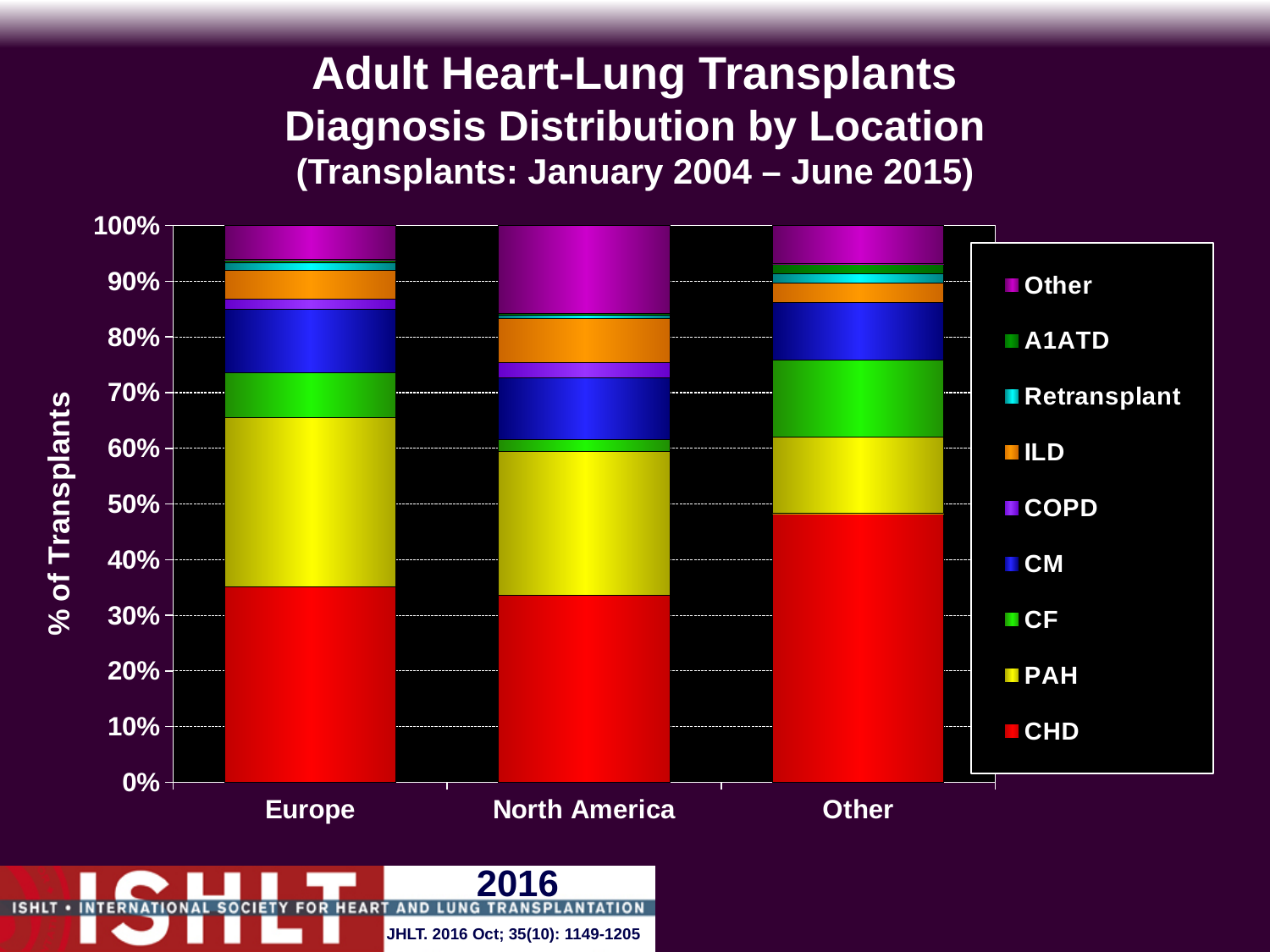
What is the label on the y axis? % of Transplants Which location has the smallest PAH share of transplants? Other Which is larger, the CF share for Other or the CF share for Europe? Other How many location categories are shown on the x axis? 3 How many diagnosis series does the legend list? 9 Which location has the largest CHD share of transplants? Other What is the total height of the Europe stacked bar? 100% Is the CHD share for Europe greater or less than 40%? less Which location has the largest share in the 'Other' diagnosis category? North America Is the CHD share for Other greater or less than 40%? greater What kind of chart is shown on the slide? Stacked bar chart Which location has the smallest CF share of transplants? North America